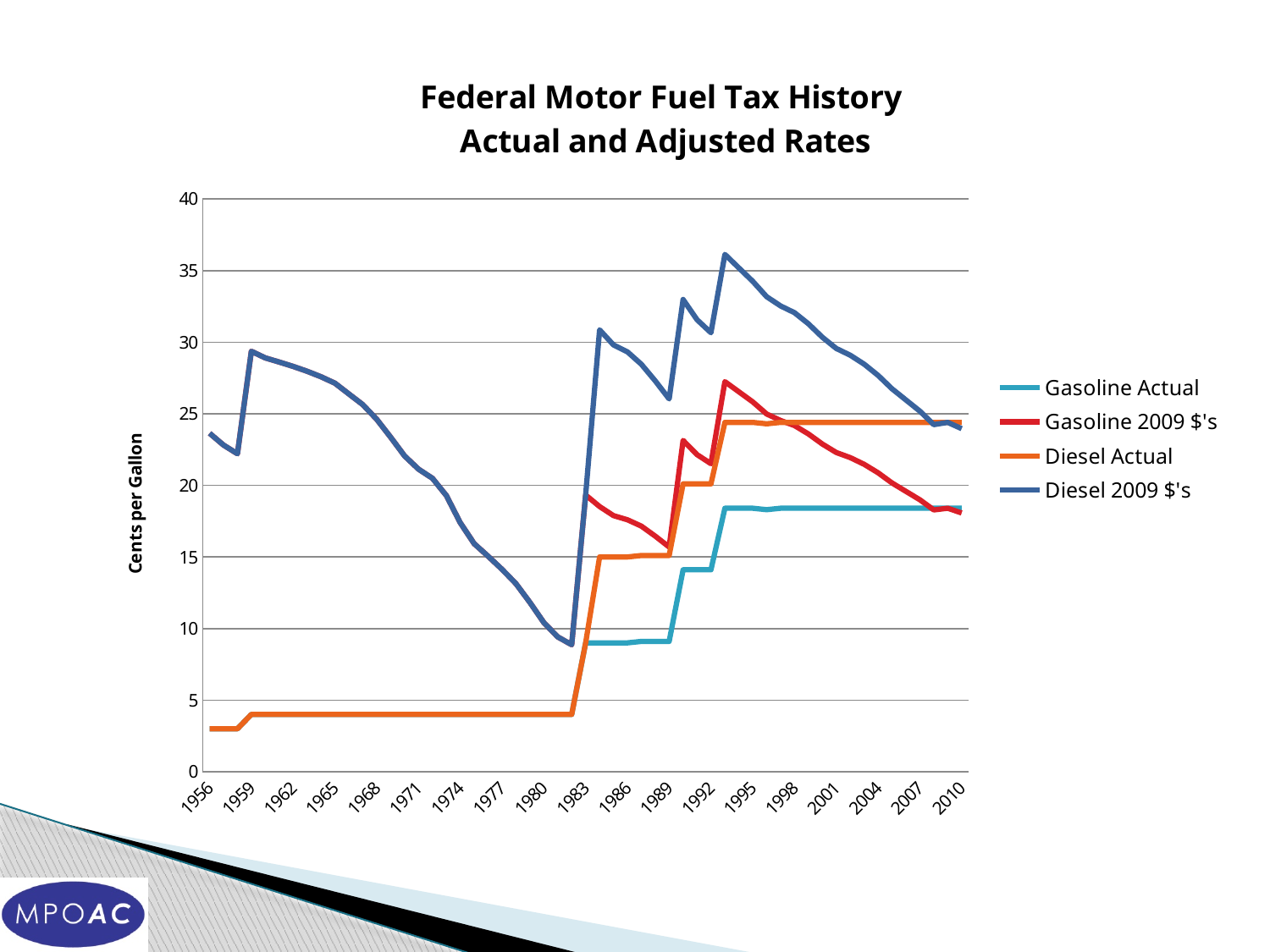
Does the Diesel 2009 $'s series rise or fall from 1995 to 2010? fall Is the value for Diesel 2009 $'s in 1980 greater or less than 15? less Is the value for Diesel 2009 $'s in 1959 greater or less than 25? greater How many year labels are shown on the x axis? 19 How many series does the legend list? 4 Is the value for Diesel 2009 $'s in 1994 greater or less than 30? greater What is the label on the vertical axis? Cents per Gallon In 2010, which is larger, Diesel Actual or Gasoline Actual? Diesel Actual What is the title of the chart? Federal Motor Fuel Tax History Actual and Adjusted Rates Which series reaches the highest value on the chart? Diesel 2009 $'s What kind of chart is shown on the slide? line chart